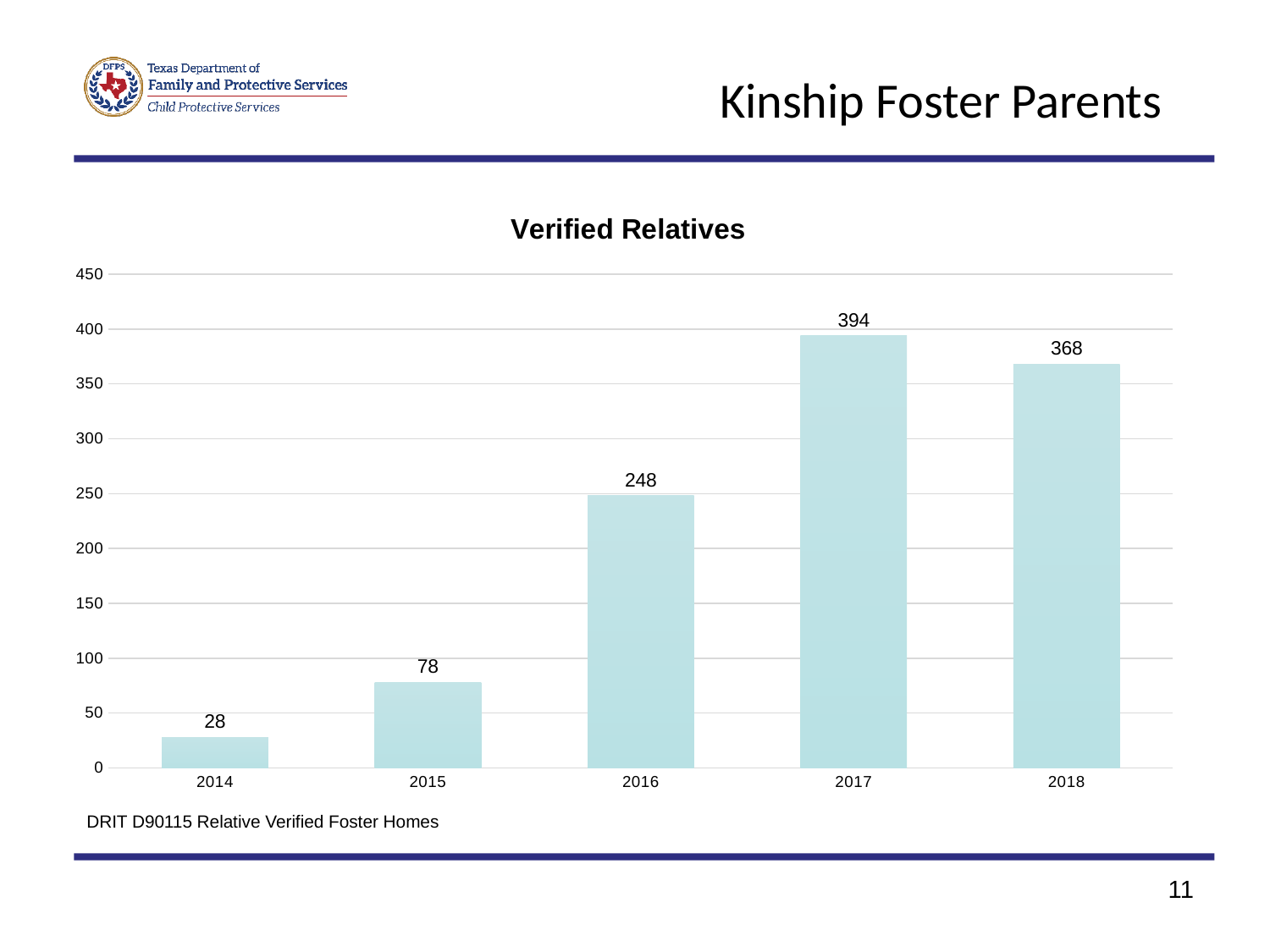
Which year has the highest value in the Verified Relatives chart? 2017 What is the value for 2016 in the Verified Relatives chart? 248 What is the title of the chart? Verified Relatives What is the value for 2014 in the Verified Relatives chart? 28 How many years are shown on the x axis of the chart? 5 What is the value for 2018 in the Verified Relatives chart? 368 What kind of chart is shown on the slide? bar chart What is the difference between the values for 2015 and 2014? 50 Is the value for 2017 greater or less than 350? greater Which is larger, the value for 2016 or the value for 2018? 2018 What is the difference between the values for 2017 and 2018? 26 Which year has the lowest value in the Verified Relatives chart? 2014